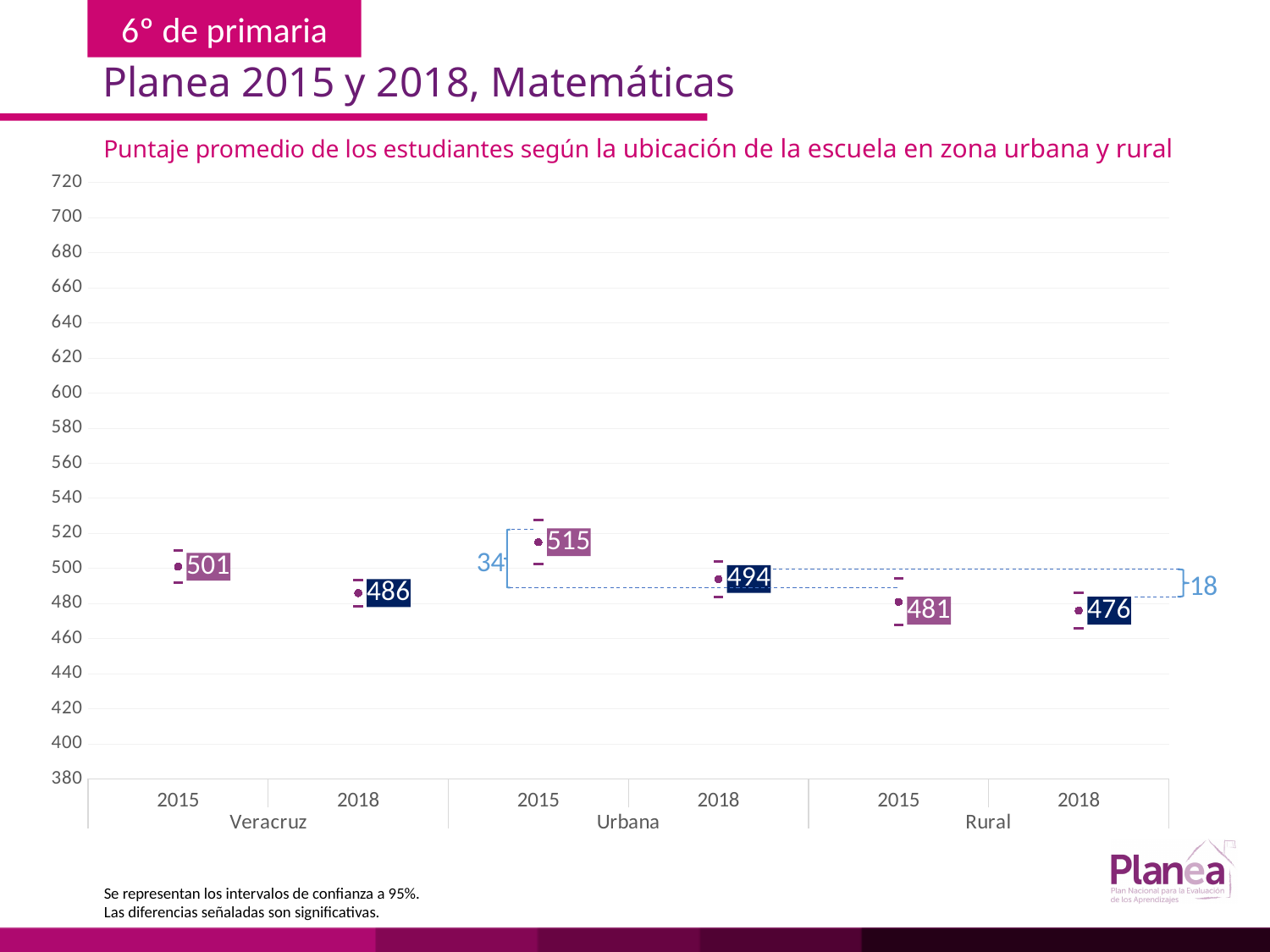
Which group and year has the highest average score? Urbana 2015 Which is larger, the Urbana 2018 score or the Rural 2018 score? Urbana 2018 How many data points are plotted on the chart? 6 What is the average score for Veracruz in 2015? 501 What is the difference between the Veracruz 2015 score and the Veracruz 2018 score? 15 What is the average score for Rural in 2015? 481 What is the difference between the Urbana 2015 score and the Rural 2015 score? 34 Which group and year has the lowest average score? Rural 2018 Is the value for Urbana 2015 greater or less than 500? greater What is the average score for Urbana in 2018? 494 What is the title of the chart? Puntaje promedio de los estudiantes según la ubicación de la escuela en zona urbana y rural From 2015 to 2018, do the Rural scores rise or fall? fall